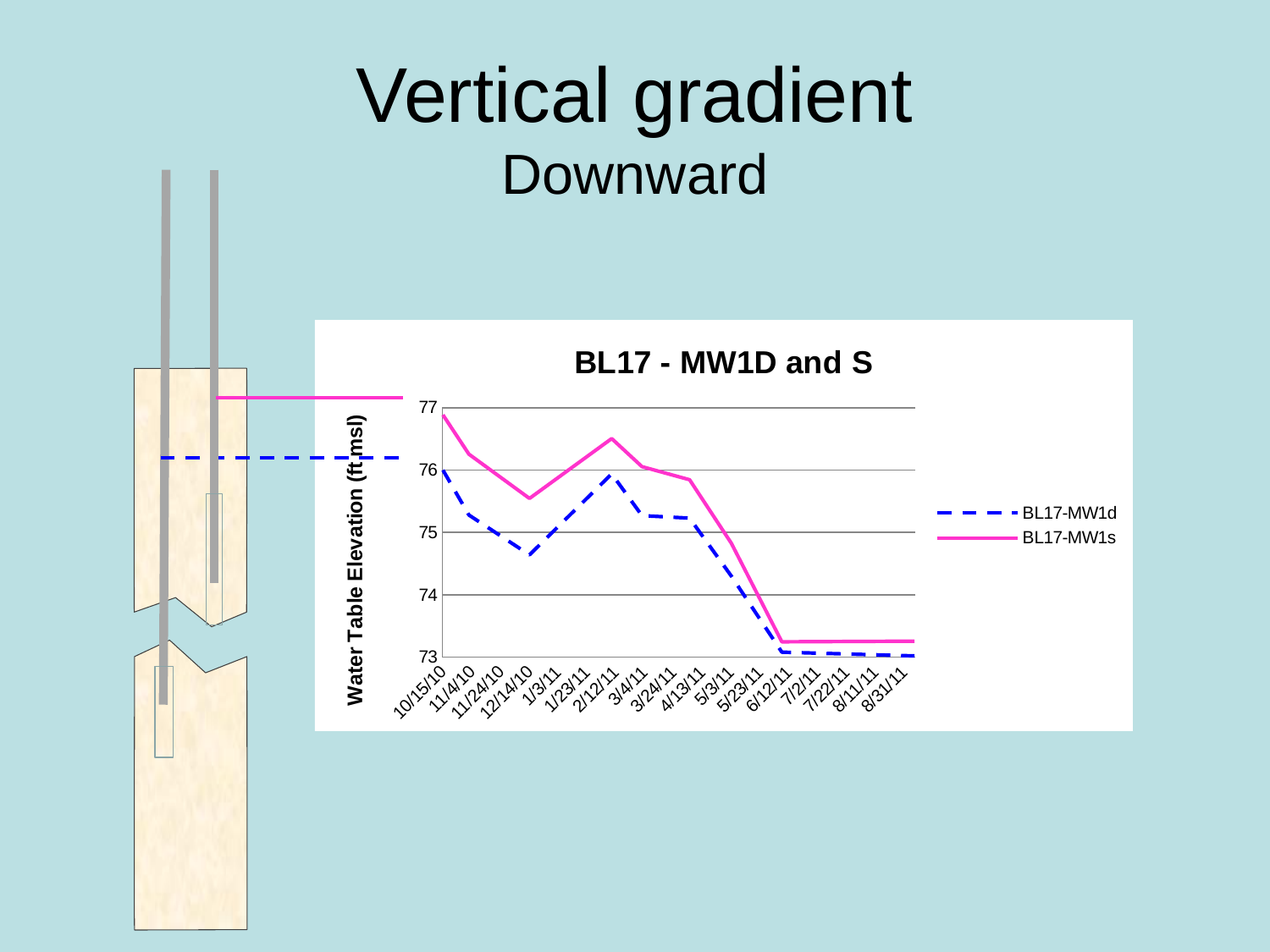
How many dates are labelled along the x axis of the chart? 17 Is the value for BL17-MW1s on 8/31/11 greater or less than 74? less Is the value for BL17-MW1d on 6/12/11 greater or less than 74? less What is the y-axis label of the chart? Water Table Elevation (ft msl) Is the value for BL17-MW1d on 12/14/10 greater or less than 75? less Overall, do the water table elevations rise or fall from 10/15/10 to 8/31/11? fall On 10/15/10, which series has the higher value, BL17-MW1d or BL17-MW1s? BL17-MW1s What kind of chart is shown on the slide? line chart What is the title of the chart? BL17 - MW1D and S How many series does the chart legend list? 2